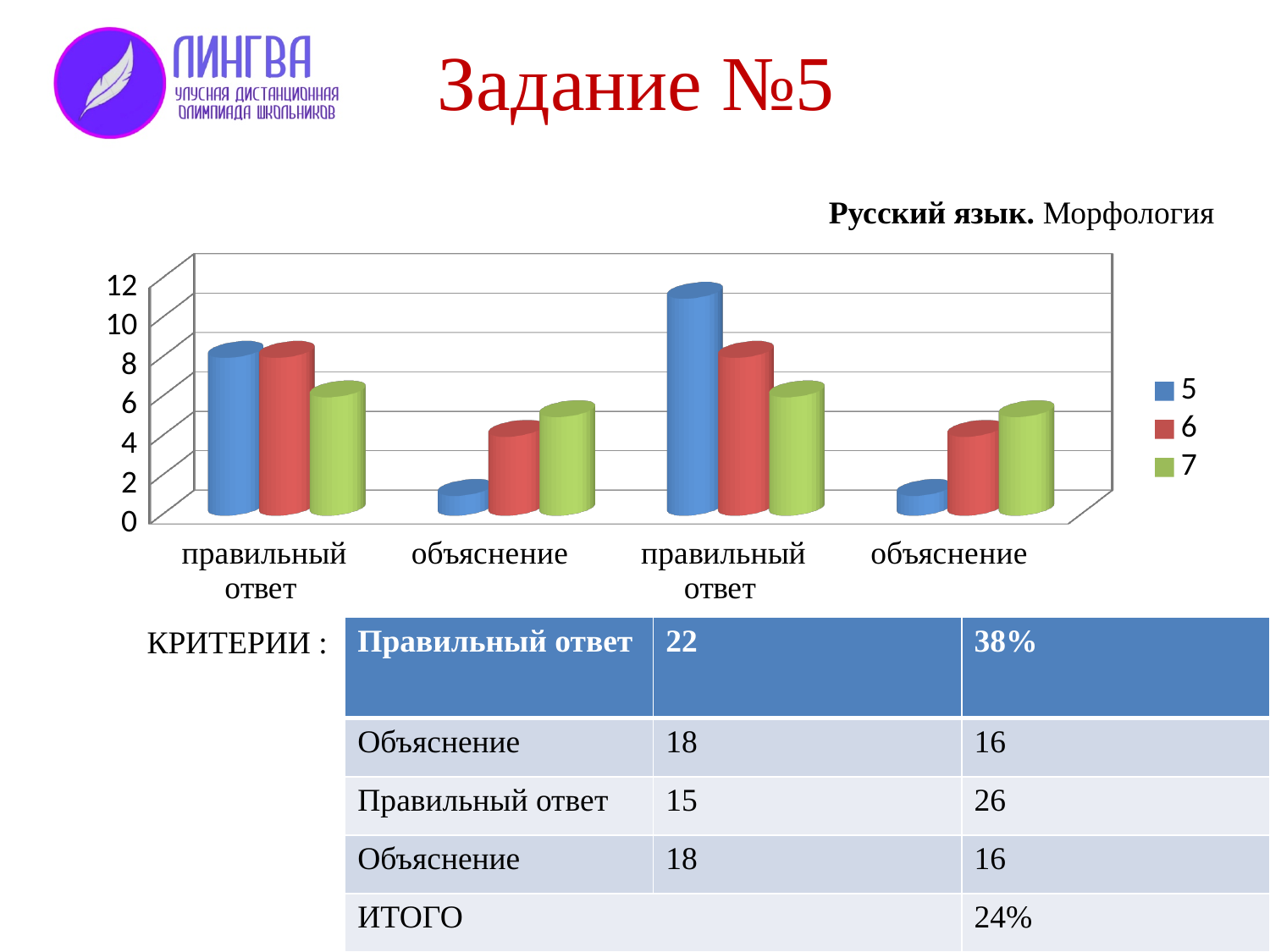
In the third category (правильный ответ), is the value for series 5 greater or less than 10? greater Which series has the tallest bar in the whole chart? 5 How many categories are shown along the x axis of the chart? 4 In the third category (правильный ответ), which series has the larger value, 5 or 7? 5 In the first category (правильный ответ), is the value for series 5 greater or less than 6? greater In the second category (объяснение), is the value for series 5 greater or less than 2? less Which series has the lowest bar in the third category (правильный ответ)? 7 How many series does the chart legend list? 3 What kind of chart is shown on the slide? bar chart What are the series names listed in the chart legend? 5, 6, 7 In the second category (объяснение), which series has the larger value, 5 or 6? 6